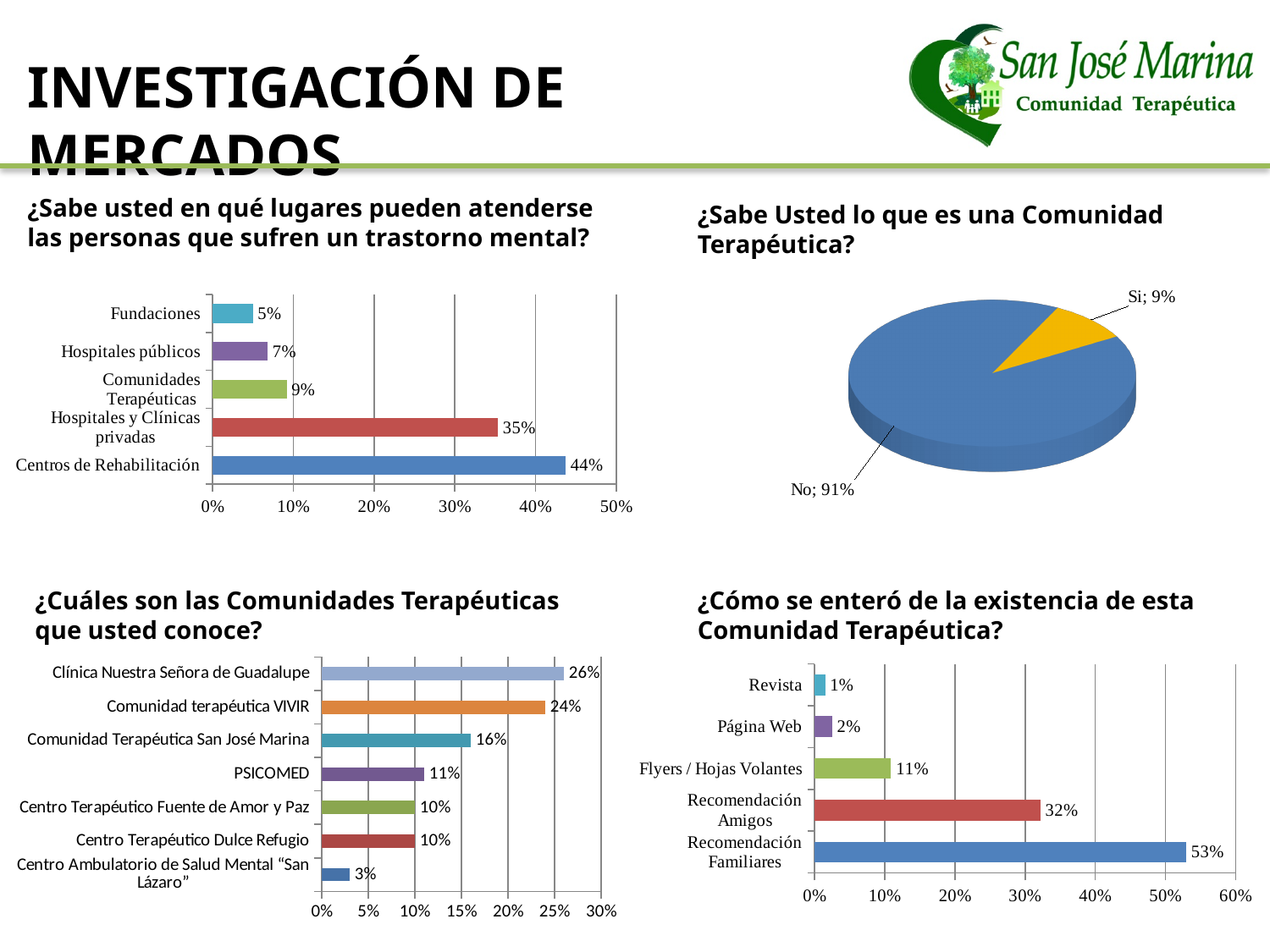
What kind of chart is used for '¿Cómo se enteró de la existencia de esta Comunidad Terapéutica?'? Bar chart In the pie chart '¿Sabe Usted lo que es una Comunidad Terapéutica?', what share of respondents answered No? 91% In the chart '¿Cómo se enteró de la existencia de esta Comunidad Terapéutica?', what is the value for Recomendación Familiares? 53% In the chart '¿Sabe usted en qué lugares pueden atenderse las personas que sufren un trastorno mental?', what is the difference between Centros de Rehabilitación and Hospitales y Clínicas privadas? 9% What kind of chart is used for '¿Sabe Usted lo que es una Comunidad Terapéutica?'? Pie chart In the chart '¿Cómo se enteró de la existencia de esta Comunidad Terapéutica?', which is larger: Flyers / Hojas Volantes or Página Web? Flyers / Hojas Volantes In the chart '¿Cuáles son las Comunidades Terapéuticas que usted conoce?', how many categories are shown? 7 In the chart '¿Cuáles son las Comunidades Terapéuticas que usted conoce?', what is the value for Comunidad Terapéutica San José Marina? 16% In the chart '¿Sabe usted en qué lugares pueden atenderse las personas que sufren un trastorno mental?', what is the value for Centros de Rehabilitación? 44% In the chart '¿Sabe usted en qué lugares pueden atenderse las personas que sufren un trastorno mental?', which category has the lowest value? Fundaciones In the pie chart '¿Sabe Usted lo que es una Comunidad Terapéutica?', how many slices are there? 2 In the chart '¿Cuáles son las Comunidades Terapéuticas que usted conoce?', which category has the highest value? Clínica Nuestra Señora de Guadalupe